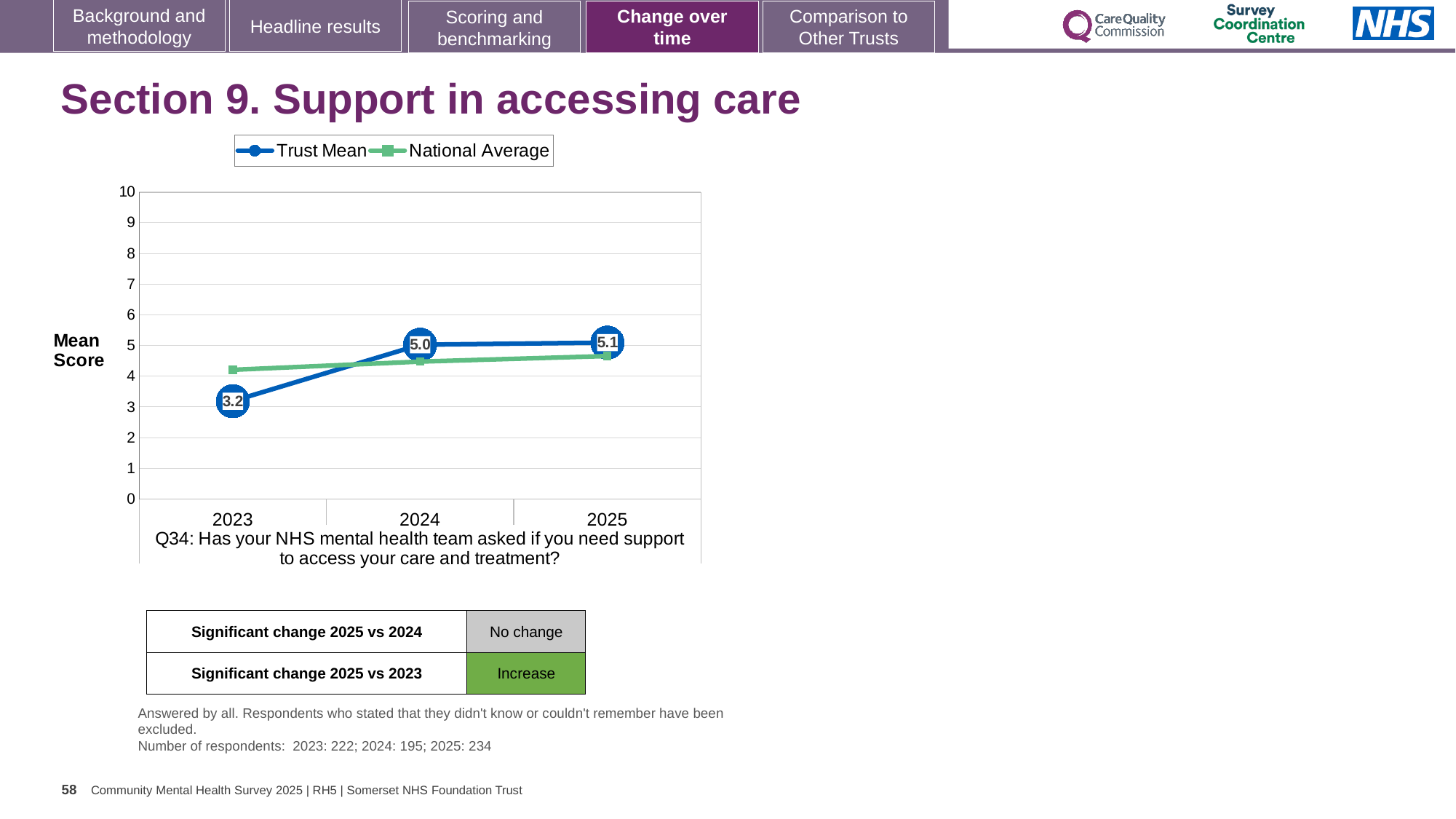
How many years are shown on the x axis of the chart? 3 Is the Trust Mean value for 2025 greater or less than 4? greater What is the difference between the Trust Mean scores for 2025 and 2023? 1.9 What is the Trust Mean score for 2023? 3.2 What kind of chart is shown on the slide? Line chart Which is larger, the Trust Mean for 2023 or the Trust Mean for 2024? 2024 Does the Trust Mean rise or fall from 2023 to 2025? Rise What is the Trust Mean score for 2025? 5.1 In which year is the Trust Mean score lowest? 2023 Is the National Average value for 2023 greater or less than 5? less What is the Trust Mean score for 2024? 5.0 How many series does the chart legend list? 2